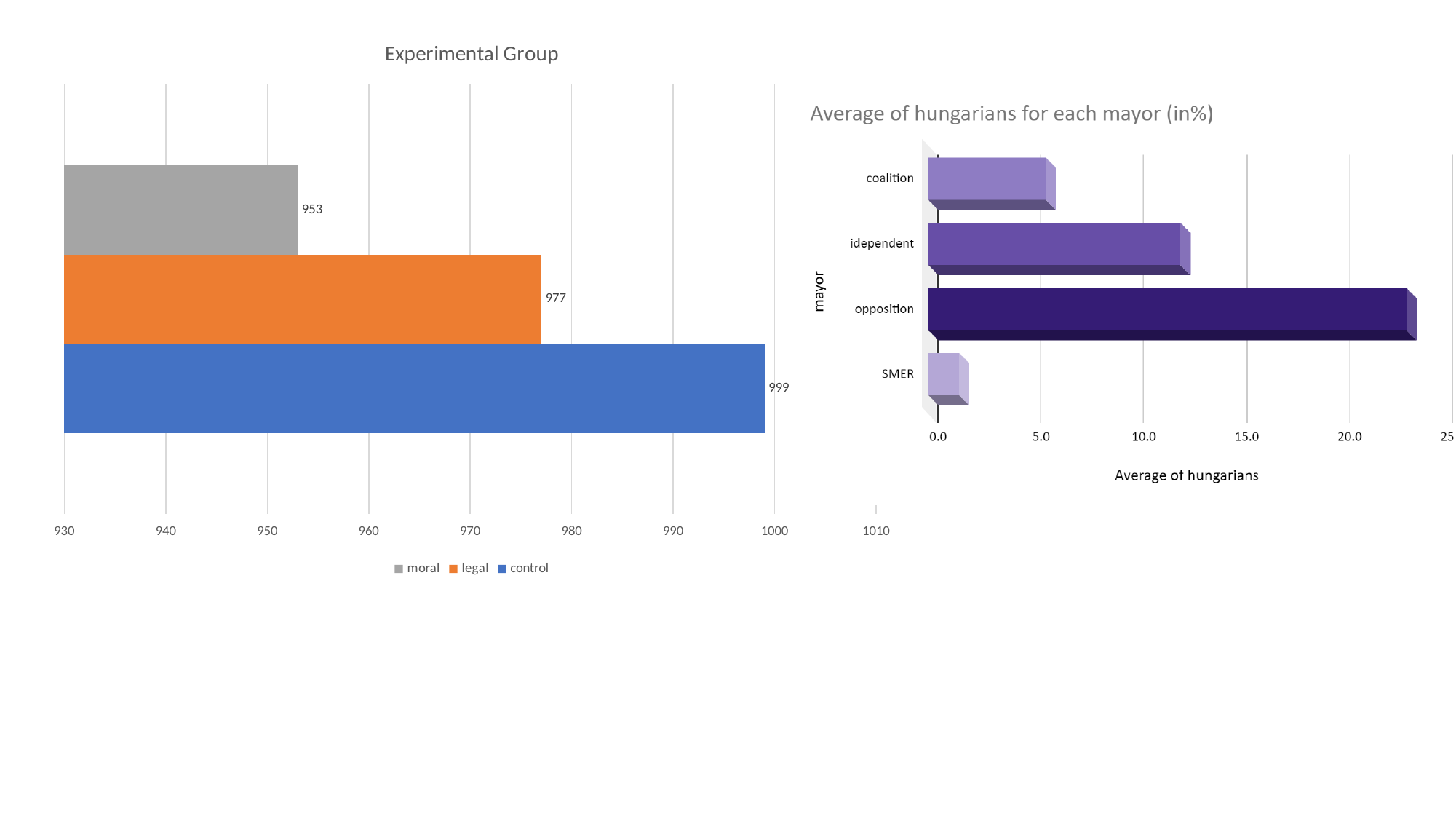
In the 'Average of hungarians for each mayor (in%)' chart, which mayor category has the lowest value? SMER In the 'Average of hungarians for each mayor (in%)' chart, is the value for opposition greater or less than 20.0? greater In the 'Experimental Group' chart, what is the value for control? 999 In the 'Average of hungarians for each mayor (in%)' chart, how many mayor categories are shown? 4 In the 'Average of hungarians for each mayor (in%)' chart, which mayor category has the highest value? opposition In the 'Experimental Group' chart, what is the difference between the control and moral values? 46 In the 'Experimental Group' chart, how many series does the legend list? 3 In the 'Experimental Group' chart, what is the value for moral? 953 What kind of chart is the 'Average of hungarians for each mayor (in%)' chart? bar chart In the 'Experimental Group' chart, what is the value for legal? 977 In the 'Experimental Group' chart, which series has the lowest value? moral In the 'Experimental Group' chart, which series has the highest value? control